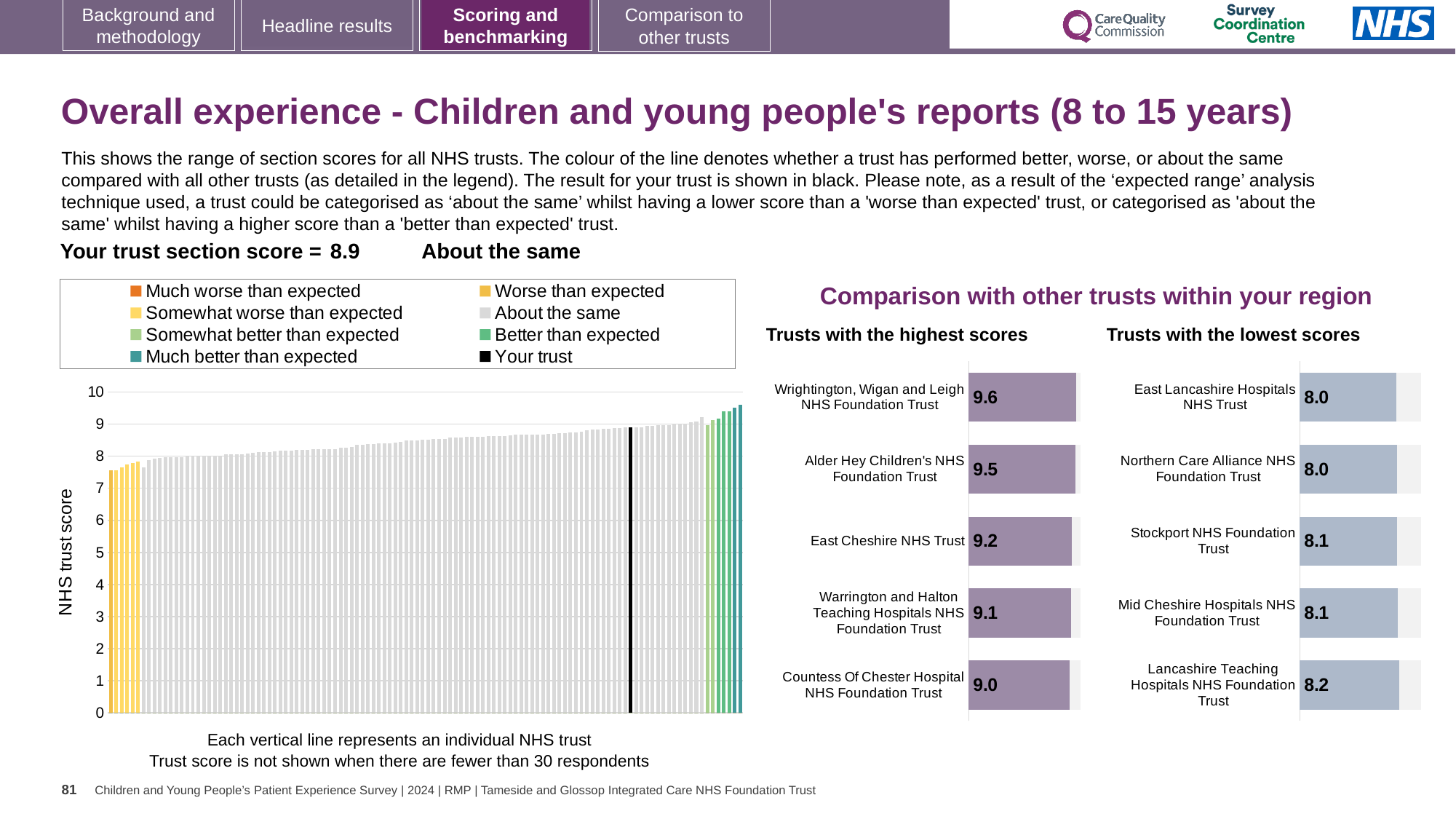
In the large chart on the left, is the value for the black bar (your trust) greater or less than 8? greater In the 'Trusts with the highest scores' chart, which trust has the lowest score? Countess Of Chester Hospital NHS Foundation Trust In the 'Trusts with the highest scores' chart, which trust has the highest score? Wrightington, Wigan and Leigh NHS Foundation Trust In the 'Trusts with the lowest scores' chart, what is the score for Lancashire Teaching Hospitals NHS Foundation Trust? 8.2 In the 'Trusts with the highest scores' chart, what is the score for East Cheshire NHS Trust? 9.2 In the 'Trusts with the lowest scores' chart, what is the difference between the scores of Lancashire Teaching Hospitals NHS Foundation Trust and East Lancashire Hospitals NHS Trust? 0.2 How many trusts are shown in the 'Trusts with the lowest scores' chart? 5 Which has the higher score: Alder Hey Children's NHS Foundation Trust in the highest scores chart or Stockport NHS Foundation Trust in the lowest scores chart? Alder Hey Children's NHS Foundation Trust In the 'Trusts with the highest scores' chart, what is the difference between the scores of Wrightington, Wigan and Leigh NHS Foundation Trust and Countess Of Chester Hospital NHS Foundation Trust? 0.6 In the 'Trusts with the highest scores' chart, what is the score for Wrightington, Wigan and Leigh NHS Foundation Trust? 9.6 How many entries does the legend of the large chart on the left list? 8 What kind of chart is the large chart on the left of the slide? Bar chart